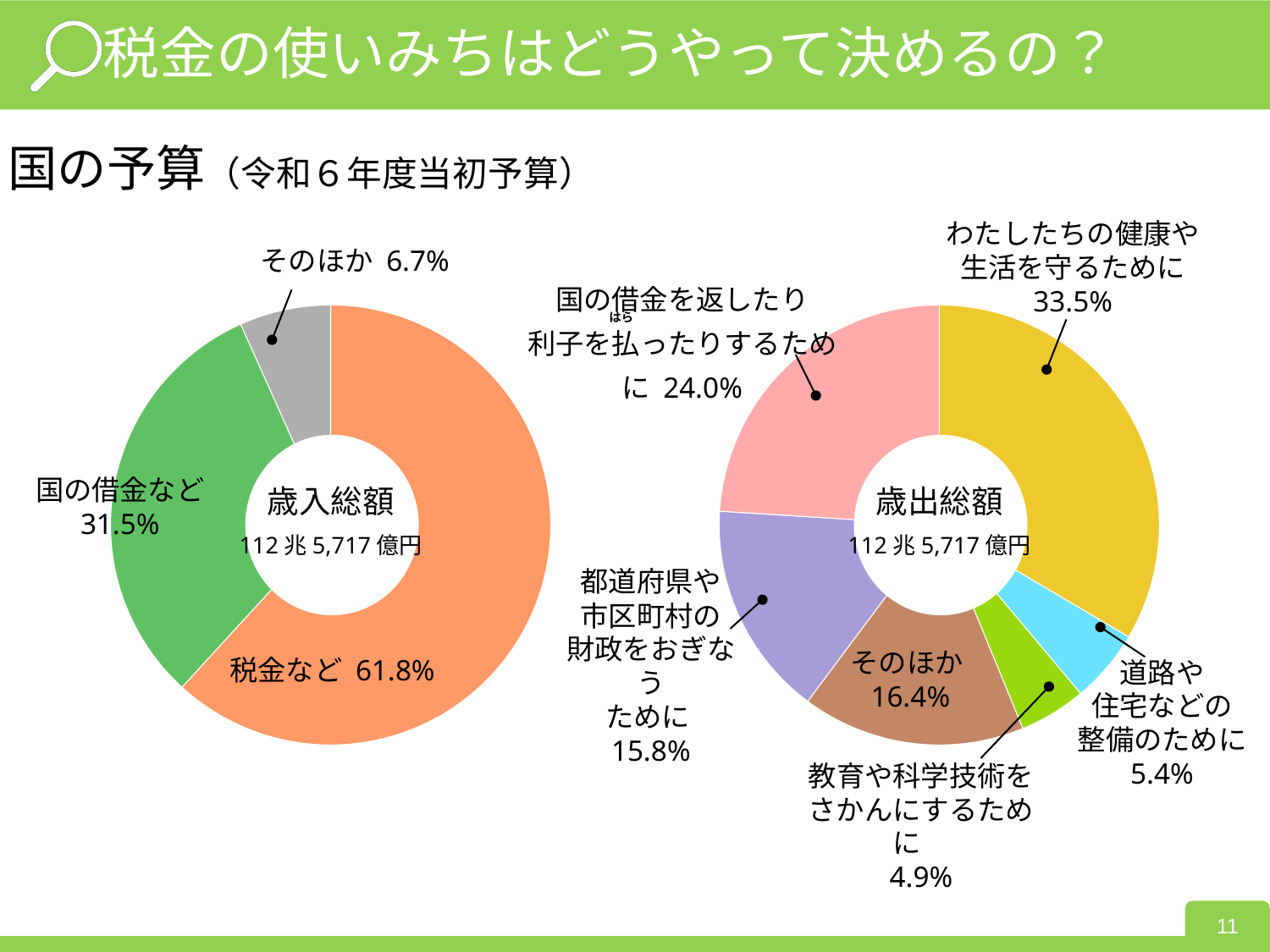
In the left chart (歳入総額), what is the difference between the shares for 税金など and 国の借金など? 30.3% What total amount is shown in the centre of the right chart (歳出総額)? 112兆5,717億円 What kind of chart is used on this slide? Pie (donut) chart In the right chart (歳出総額), which category has the largest share? わたしたちの健康や生活を守るために In the right chart (歳出総額), how many categories are shown? 6 In the left chart (歳入総額), what share is labelled for 税金など? 61.8% In the left chart (歳入総額), which category has the smallest share? そのほか In the left chart (歳入総額), how many categories are shown? 3 In the right chart (歳出総額), what share is labelled for 教育や科学技術をさかんにするために? 4.9% In the left chart (歳入総額), what share is labelled for 国の借金など? 31.5% In the right chart (歳出総額), which is larger: そのほか or 都道府県や市区町村の財政をおぎなうために? そのほか In the right chart (歳出総額), what share is labelled for わたしたちの健康や生活を守るために? 33.5%